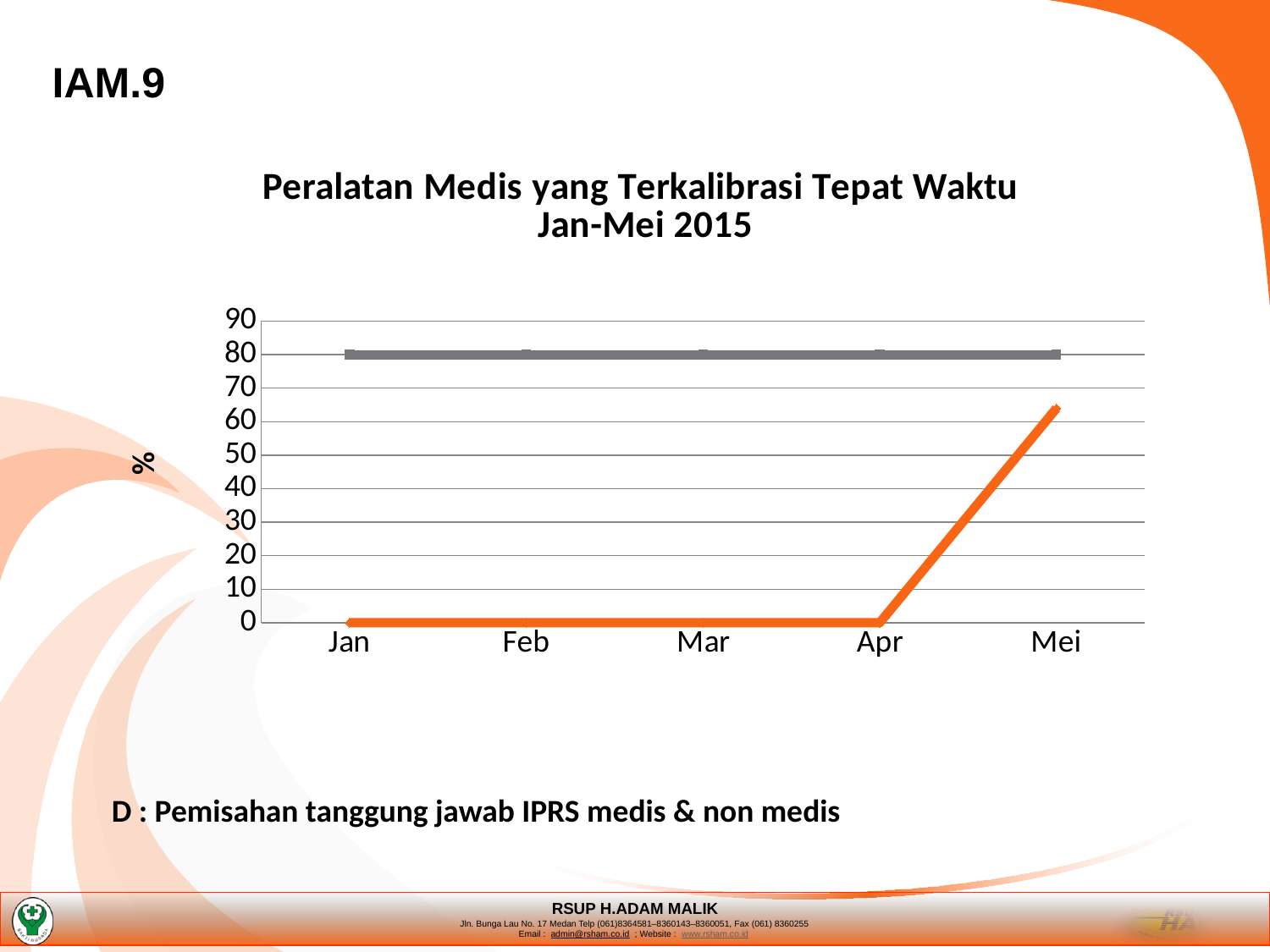
What is the label on the vertical axis of the chart? % Is the value of the orange line for Mei greater or less than 70? less What value does the orange line show for Jan? 0 In which month does the orange line reach its highest value? Mei How many months are shown on the x axis of the chart? 5 What value does the gray line show for Mar? 80 What is the title of the chart? Peralatan Medis yang Terkalibrasi Tepat Waktu Jan-Mei 2015 In Mei, which line is higher, the gray line or the orange line? gray line Is the value of the orange line for Mei greater or less than 50? greater Does the orange line rise or fall between Apr and Mei? rise What is the difference between the gray line and the orange line in Feb? 80 What kind of chart is shown on the slide? line chart